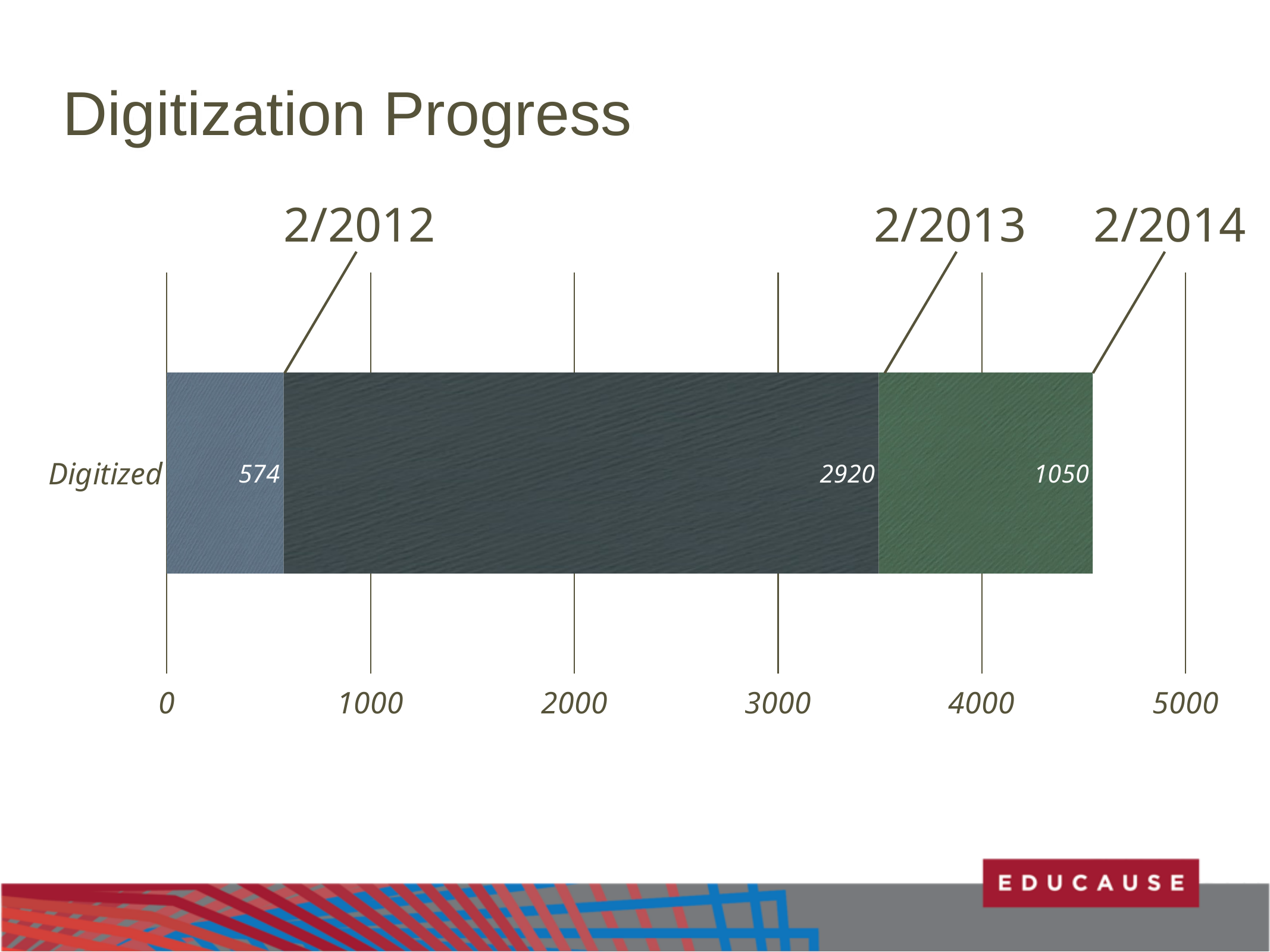
What is the difference between the 2/2013 segment and the 2/2014 segment? 1870 What is the value of the middle segment of the Digitized bar, labelled 2/2013? 2920 What is the total of the stacked Digitized bar? 4544 Which segment of the Digitized bar has the smallest value? 2/2012 What is the title of the slide containing the chart? Digitization Progress What kind of chart is shown on the slide? Stacked bar chart Is the total length of the Digitized bar greater or less than 4000? greater What is the value of the first (leftmost) segment of the Digitized bar, labelled 2/2012? 574 What is the value of the rightmost segment of the Digitized bar, labelled 2/2014? 1050 What is the difference between the 2/2014 segment and the 2/2012 segment? 476 Which segment of the Digitized bar has the largest value? 2/2013 Which is larger, the 2/2012 segment or the 2/2014 segment? 2/2014